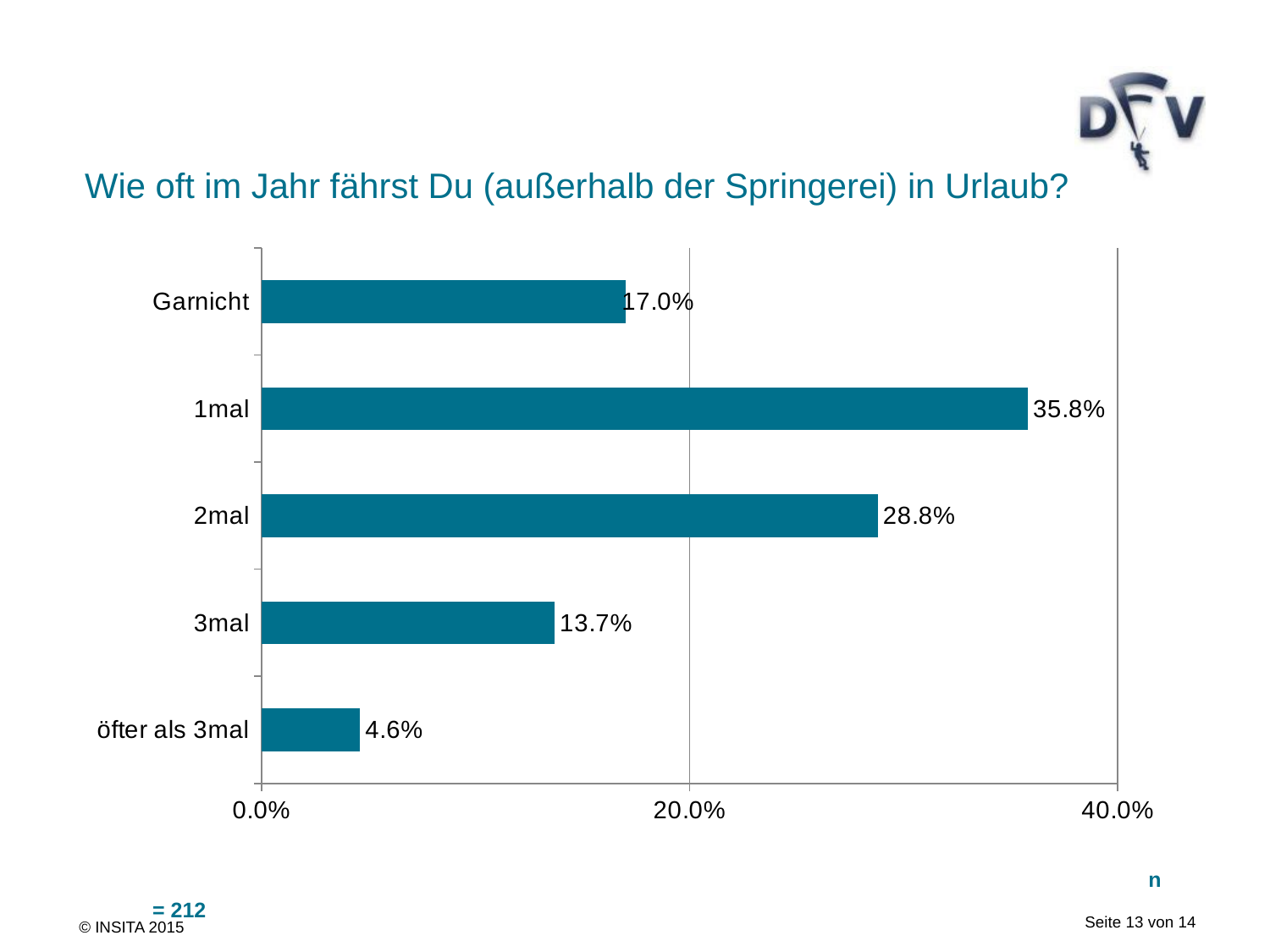
What kind of chart is shown on the slide? bar chart Which is larger, the value for "Garnicht" or the value for "3mal"? Garnicht What is the value for "öfter als 3mal"? 4.6% Is the value for "2mal" greater or less than 20.0%? greater Which category has the highest value? 1mal How many categories are shown in the chart? 5 What is the title of the chart? Wie oft im Jahr fährst Du (außerhalb der Springerei) in Urlaub? What is the value for "Garnicht"? 17.0% What is the difference between the values for "1mal" and "2mal"? 7.0% What is the sample size (n) shown on the slide? 212 What is the value for "1mal"? 35.8% Which category has the lowest value? öfter als 3mal